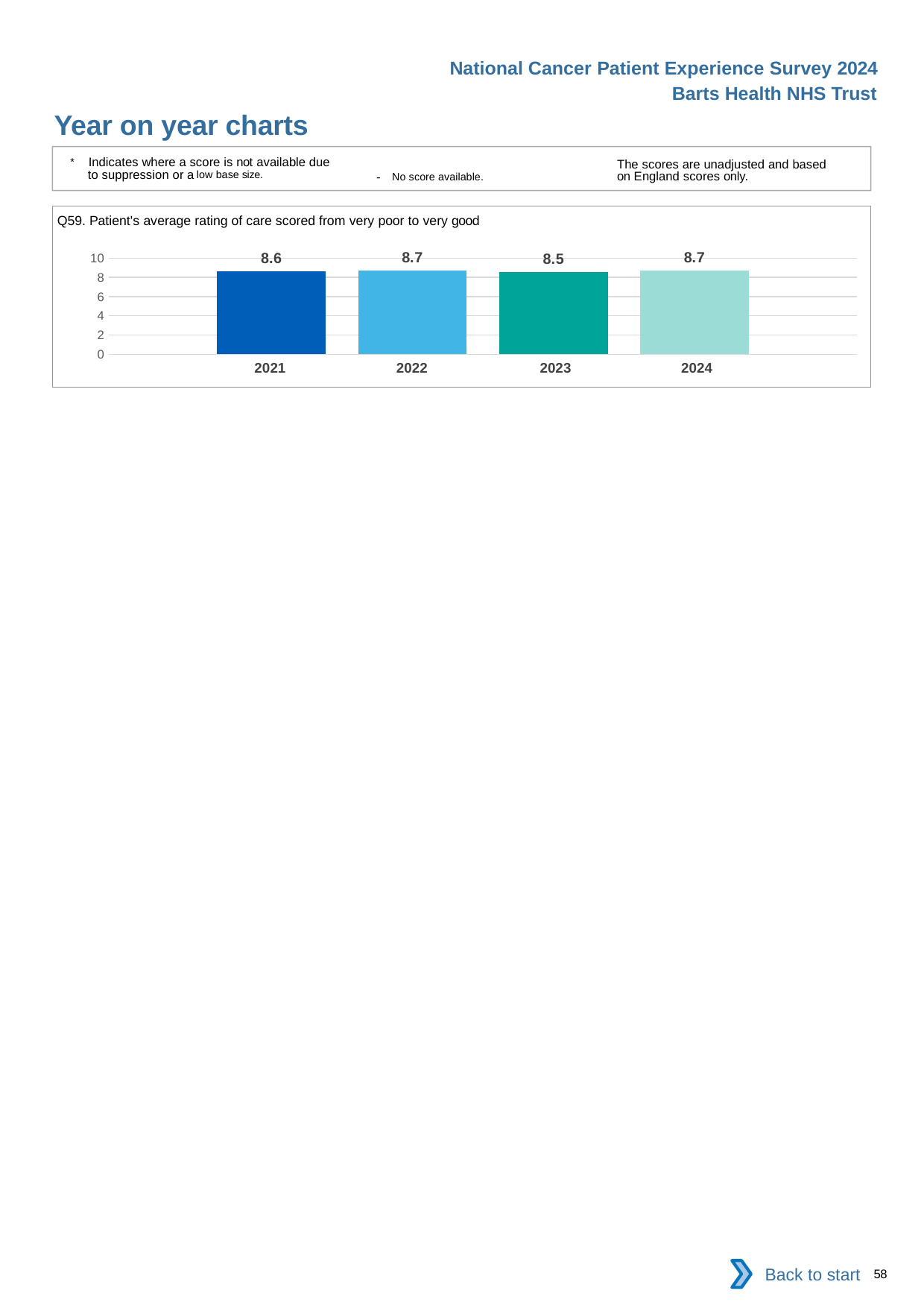
What kind of chart is shown? bar chart How many years are shown on the chart? 4 What is the value for 2024? 8.7 What is the title of the chart? Q59. Patient's average rating of care scored from very poor to very good What is the value for 2021? 8.6 What is the difference between the values for 2024 and 2023? 0.2 Which year has the lowest value? 2023 Is the value for 2022 greater or less than 8? greater Which is larger, the value for 2021 or the value for 2023? 2021 What is the maximum value shown on the y axis? 10 What is the value for 2023? 8.5 What is the difference between the values for 2022 and 2021? 0.1